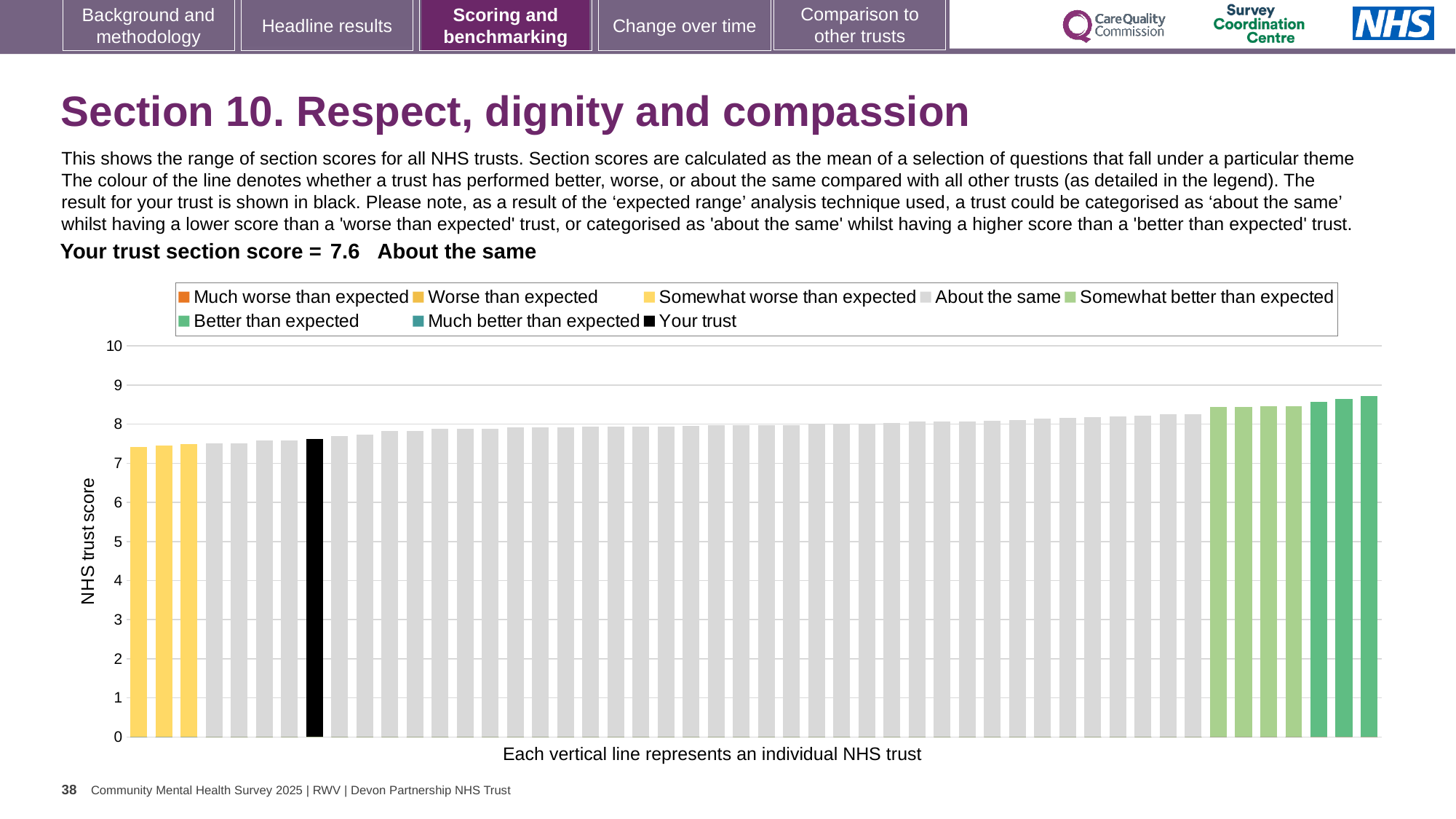
What kind of chart is shown on the slide? bar chart Is the value for your trust (the black bar) greater or less than 7? greater How many entries does the chart legend list? 8 Is the shortest bar in the chart greater or less than 7? greater What is the title of the vertical axis? NHS trust score How many bars are coloured as 'Somewhat better than expected' (light green)? 4 Is the value for your trust (the black bar) greater or less than 8? less What colour is the bar representing your trust? black Do the bar values rise or fall from left to right along the x axis? rise What is the section score for your trust? 7.6